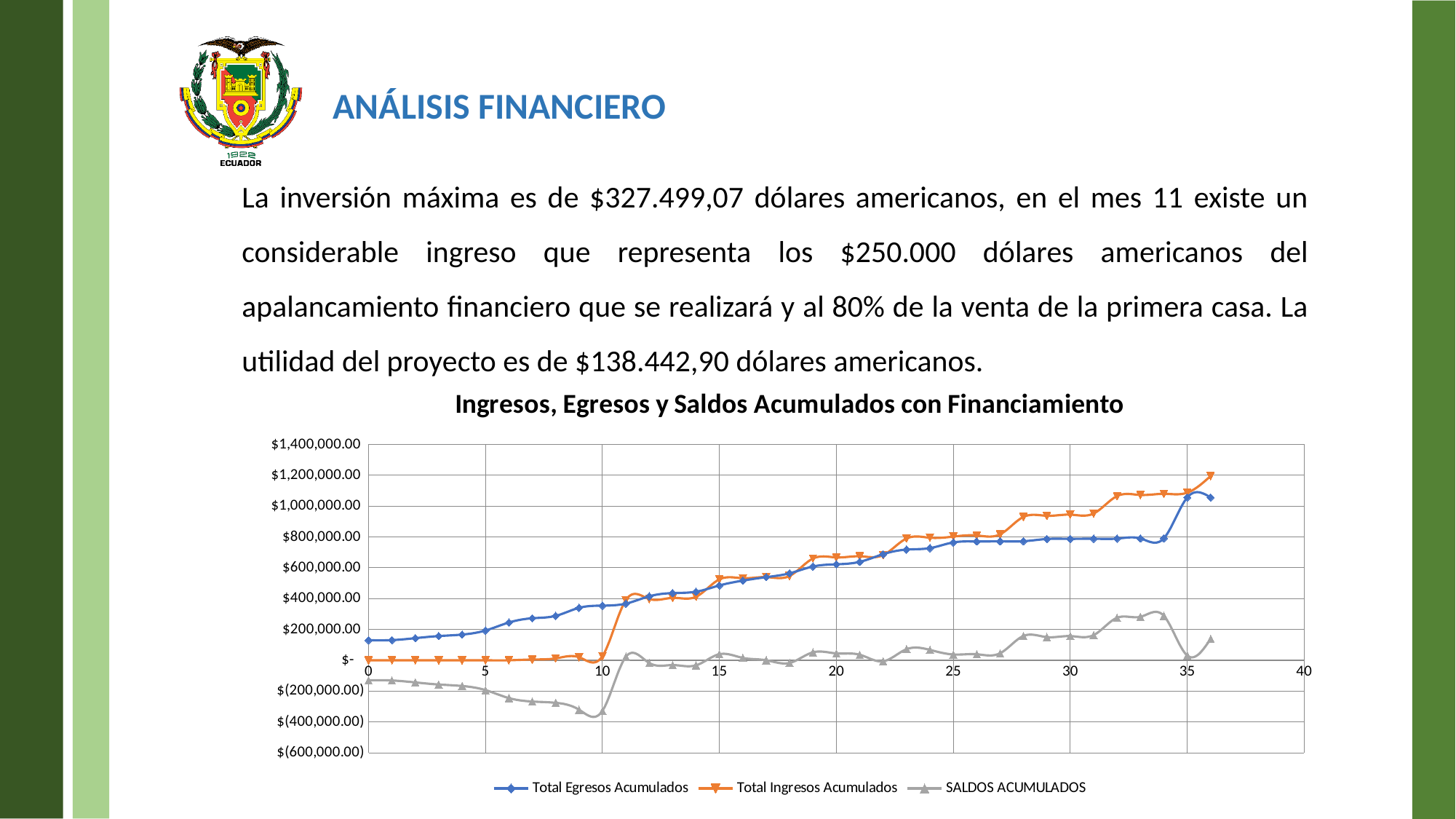
At x = 5, which is larger: Total Egresos Acumulados or Total Ingresos Acumulados? Total Egresos Acumulados Does the Total Egresos Acumulados series generally rise or fall along the x axis? Rise How many series does the legend of the chart list? 3 Is the value of Total Ingresos Acumulados at x = 35 greater or less than $1,000,000.00? greater Which series is drawn in orange in the chart? Total Ingresos Acumulados At x = 30, which is larger: Total Ingresos Acumulados or Total Egresos Acumulados? Total Ingresos Acumulados What kind of chart is shown on the slide? Line chart Around which x value does the SALDOS ACUMULADOS series reach its lowest point? 10 Is the value of SALDOS ACUMULADOS at x = 10 greater or less than $(200,000.00)? less Is the value of Total Ingresos Acumulados at x = 5 greater or less than $200,000.00? less What is the title of the chart? Ingresos, Egresos y Saldos Acumulados con Financiamiento